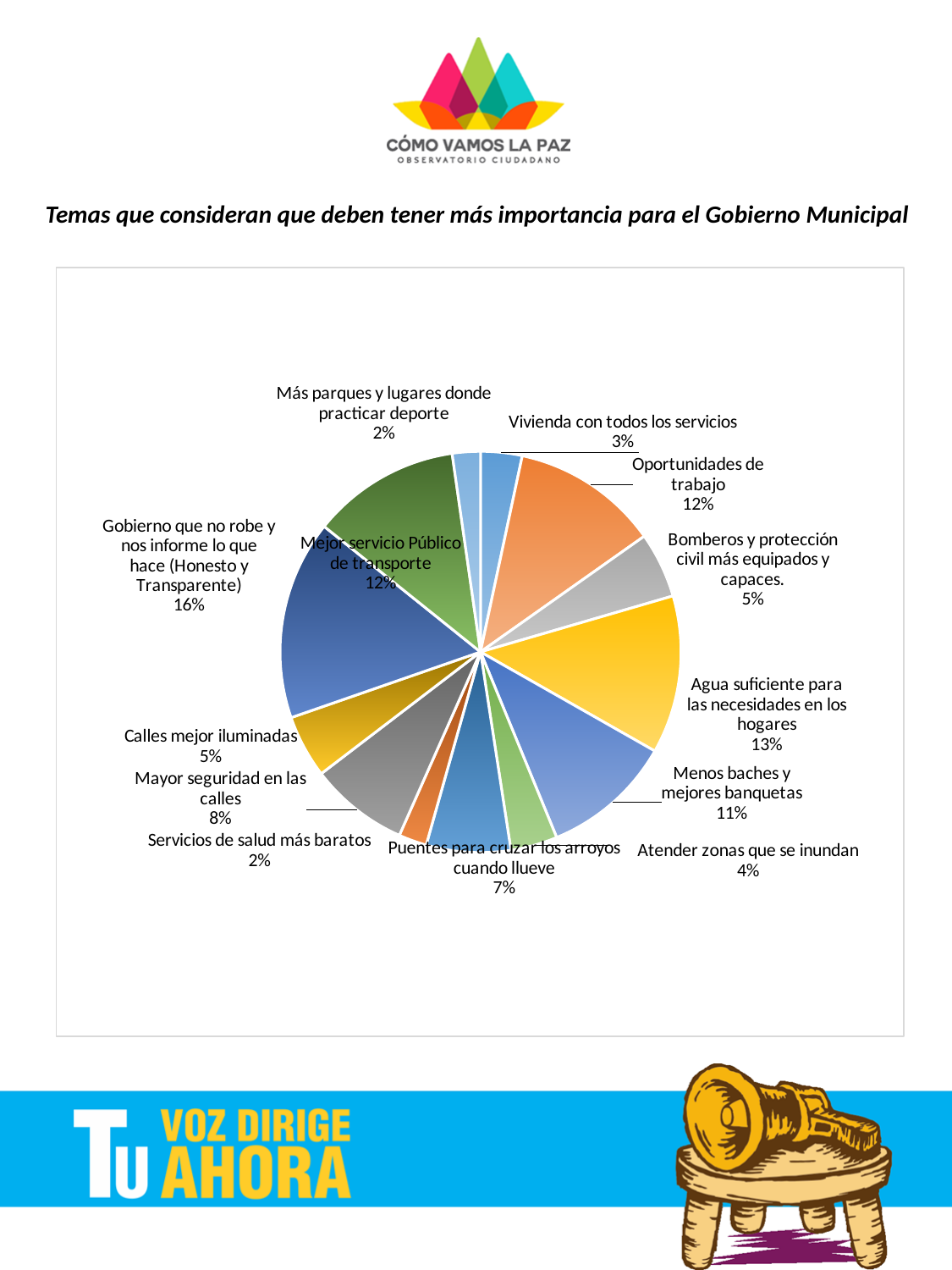
What is the title of the chart? Temas que consideran que deben tener más importancia para el Gobierno Municipal What percentage is shown for "Mayor seguridad en las calles"? 8% What percentage is shown for "Puentes para cruzar los arroyos cuando llueve"? 7% What percentage is shown for "Atender zonas que se inundan"? 4% What is the share of the pie for "Gobierno que no robe y nos informe lo que hace (Honesto y Transparente)"? 16% How many slices does the pie chart have? 13 What is the difference in percentage points between "Oportunidades de trabajo" and "Vivienda con todos los servicios"? 9 Which is larger, "Calles mejor iluminadas" or "Mayor seguridad en las calles"? Mayor seguridad en las calles Which topic has the largest share of the pie? Gobierno que no robe y nos informe lo que hace (Honesto y Transparente) What percentage is shown for "Agua suficiente para las necesidades en los hogares"? 13% What percentage is shown for "Menos baches y mejores banquetas"? 11% What kind of chart is shown on the slide? Pie chart